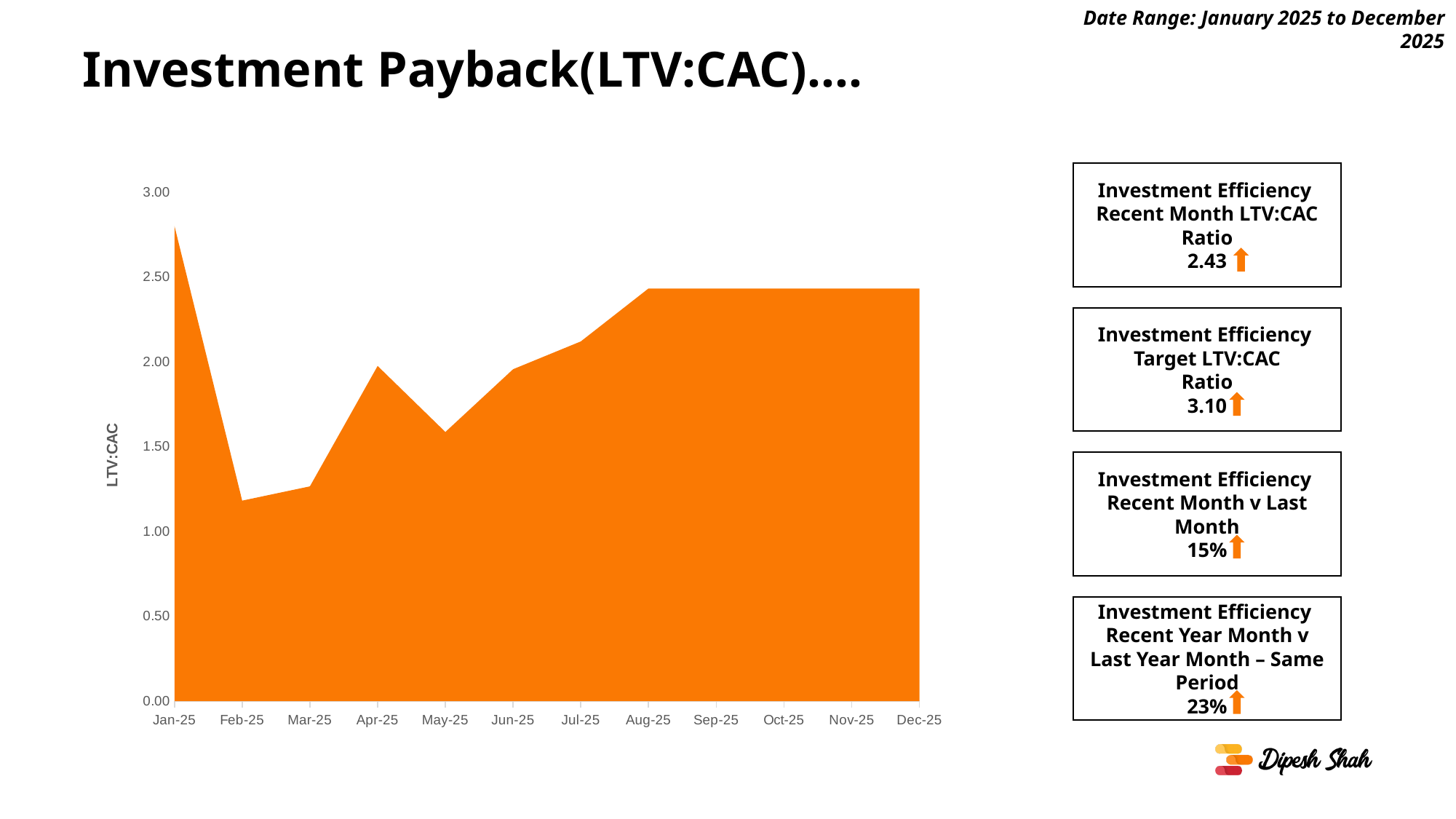
Is the LTV:CAC value for Jan-25 greater or less than 2.50? greater Does the LTV:CAC value rise or fall from Feb-25 to Apr-25? Rise What kind of chart is shown on the slide? Area chart Is the LTV:CAC value for Jul-25 greater or less than 2.00? greater Which month has the highest LTV:CAC value in the chart? Jan-25 Which month has a larger LTV:CAC value, Jan-25 or Dec-25? Jan-25 Which month has a larger LTV:CAC value, Apr-25 or May-25? Apr-25 How many months are plotted along the x axis of the chart? 12 Does the LTV:CAC value rise, fall or stay flat from Aug-25 to Dec-25? Stays flat Is the LTV:CAC value for Feb-25 greater or less than 1.50? less What is the label on the y axis of the chart? LTV:CAC Which month has the lowest LTV:CAC value in the chart? Feb-25